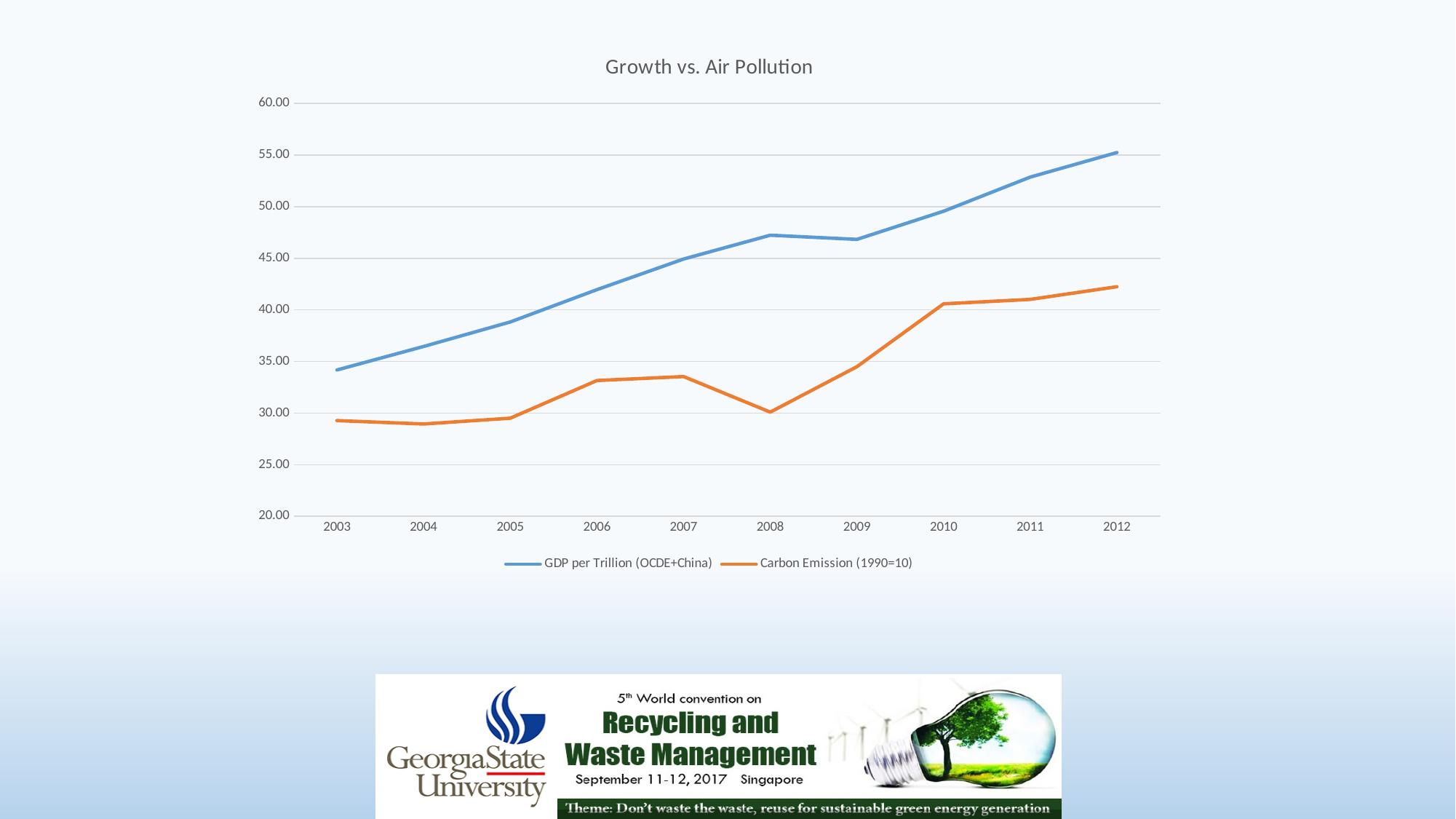
Which series has the larger value in 2007, GDP per Trillion (OCDE+China) or Carbon Emission (1990=10)? GDP per Trillion (OCDE+China) Which series is drawn in orange? Carbon Emission (1990=10) Is the value for Carbon Emission (1990=10) in 2012 greater or less than 40.00? greater How many series does the legend list? 2 In which year is GDP per Trillion (OCDE+China) highest? 2012 In which year is Carbon Emission (1990=10) highest? 2012 How many years are plotted along the x axis? 10 In which year is GDP per Trillion (OCDE+China) lowest? 2003 Is the value for GDP per Trillion (OCDE+China) in 2003 greater or less than 35.00? less What is the title of the chart? Growth vs. Air Pollution What kind of chart is shown on the slide? line chart Does Carbon Emission (1990=10) rise or fall from 2007 to 2008? fall